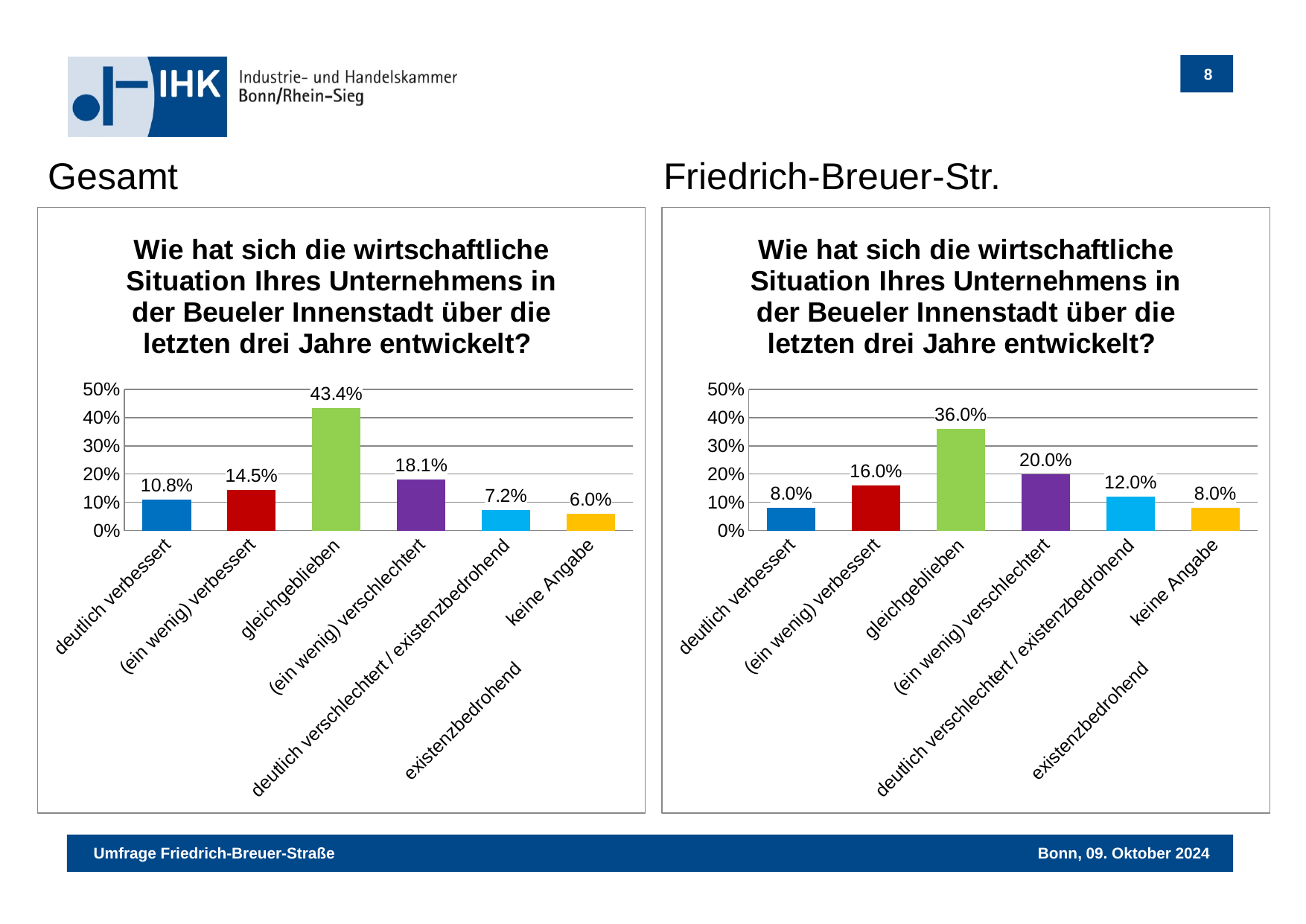
In the left chart (Gesamt), what is the difference between "gleichgeblieben" and "(ein wenig) verschlechtert"? 25.3% In the left chart (Gesamt), which category has the lowest value? keine Angabe What kind of chart is the right chart (Friedrich-Breuer-Str.)? bar chart In the left chart (Gesamt), which is larger: "deutlich verbessert" or "(ein wenig) verbessert"? (ein wenig) verbessert In the right chart (Friedrich-Breuer-Str.), what colour is the bar for "gleichgeblieben"? green In the left chart (Gesamt), what is the value for "deutlich verschlechtert / existenzbedrohend"? 7.2% In the right chart (Friedrich-Breuer-Str.), what is the value for "(ein wenig) verschlechtert"? 20.0% How many categories are shown in the left chart (Gesamt)? 6 In the right chart (Friedrich-Breuer-Str.), what is the difference between "(ein wenig) verbessert" and "deutlich verbessert"? 8.0% In the right chart (Friedrich-Breuer-Str.), is the value for "gleichgeblieben" greater or less than 30%? greater In the right chart (Friedrich-Breuer-Str.), which category has the highest value? gleichgeblieben In the left chart (Gesamt), what is the value for "gleichgeblieben"? 43.4%